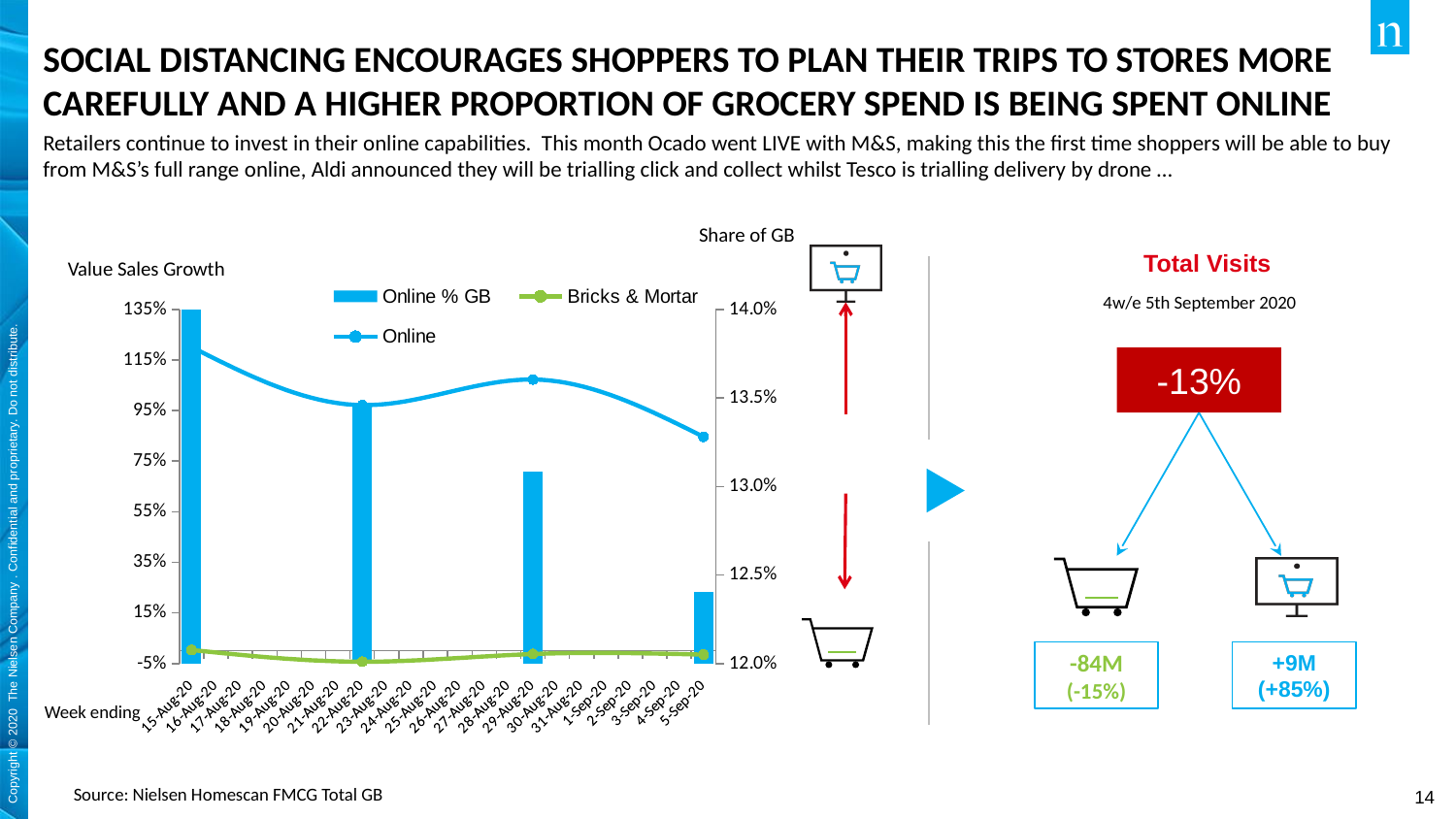
How many bars are plotted for the Online % GB series? 4 How many series does the chart legend list? 3 Does the Online value sales growth line rise or fall overall from 15-Aug-20 to 5-Sep-20? Fall Which series is plotted as bars in the chart? Online % GB Is the Online value sales growth for the week ending 5-Sep-20 greater or less than 95%? less What kind of chart is shown on the slide? A combined bar and line chart Which series shows higher value sales growth across the chart, Online or Bricks & Mortar? Online Is the Online value sales growth for the week ending 15-Aug-20 greater or less than 95%? greater Is the Online % GB value for the week ending 22-Aug-20 greater or less than 13.0%? greater For which week ending is the Online % GB bar the tallest? 15-Aug-20 For which week ending is the Online % GB bar the shortest? 5-Sep-20 What is the title of the right-hand axis of the chart? Share of GB